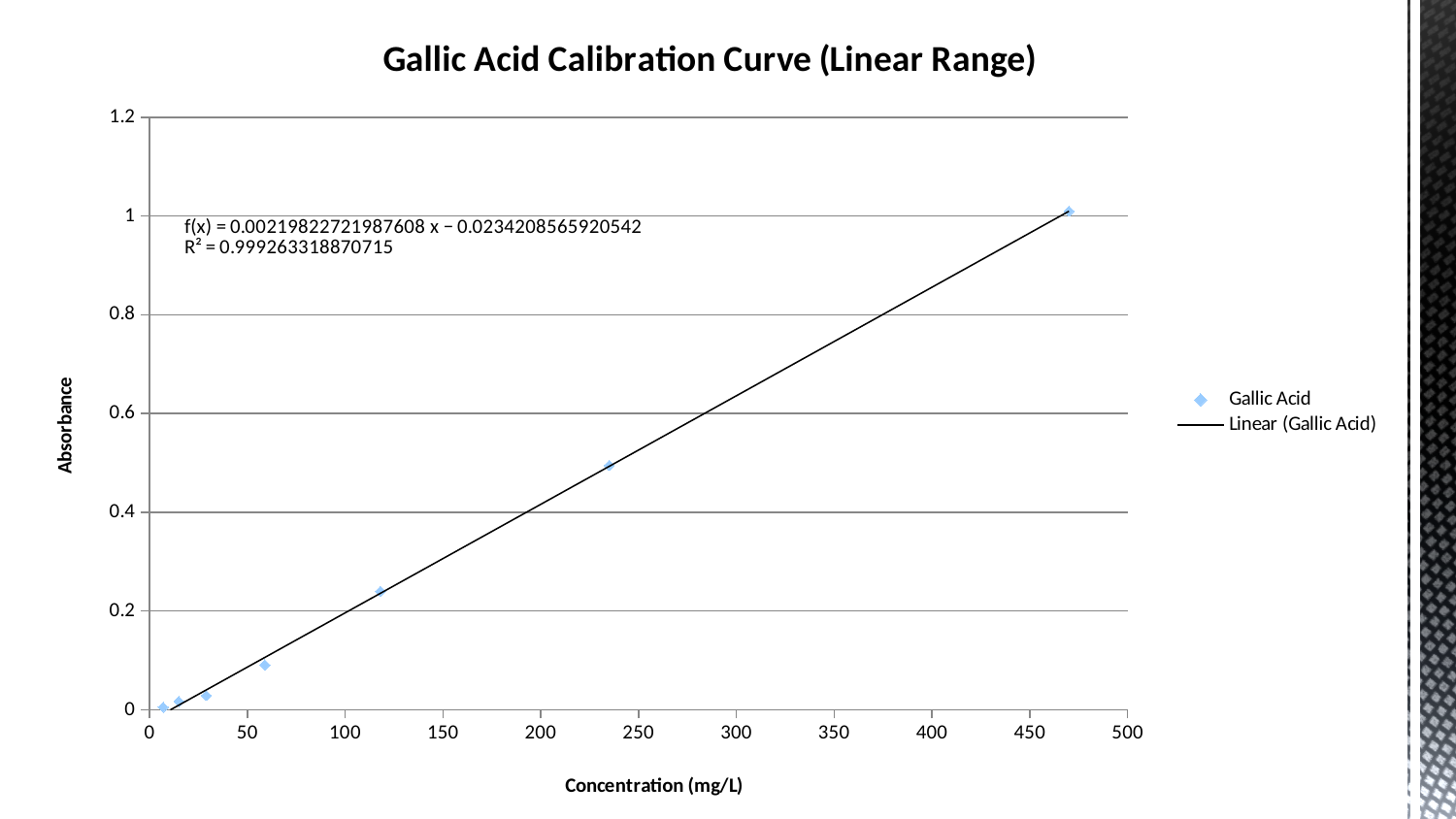
What is the fitted equation f(x) printed on the chart? f(x) = 0.00219822721987608 x − 0.0234208565920542 How many entries does the chart legend list? 2 Is the absorbance of the data point near 235 mg/L greater or less than 0.6? less How many Gallic Acid data points are plotted? 7 What is the label of the x axis? Concentration (mg/L) Do the absorbance values rise or fall as concentration increases along the x axis? rise Which has the higher absorbance: the data point near 235 mg/L or the data point near 470 mg/L? the point near 470 mg/L Is the absorbance of the data point near 118 mg/L greater or less than 0.2? greater What kind of chart is shown on the slide? scatter chart What is the title of the chart? Gallic Acid Calibration Curve (Linear Range) Is the absorbance of the data point at the highest concentration greater or less than 0.8? greater What R² value is printed on the chart? 0.999263318870715